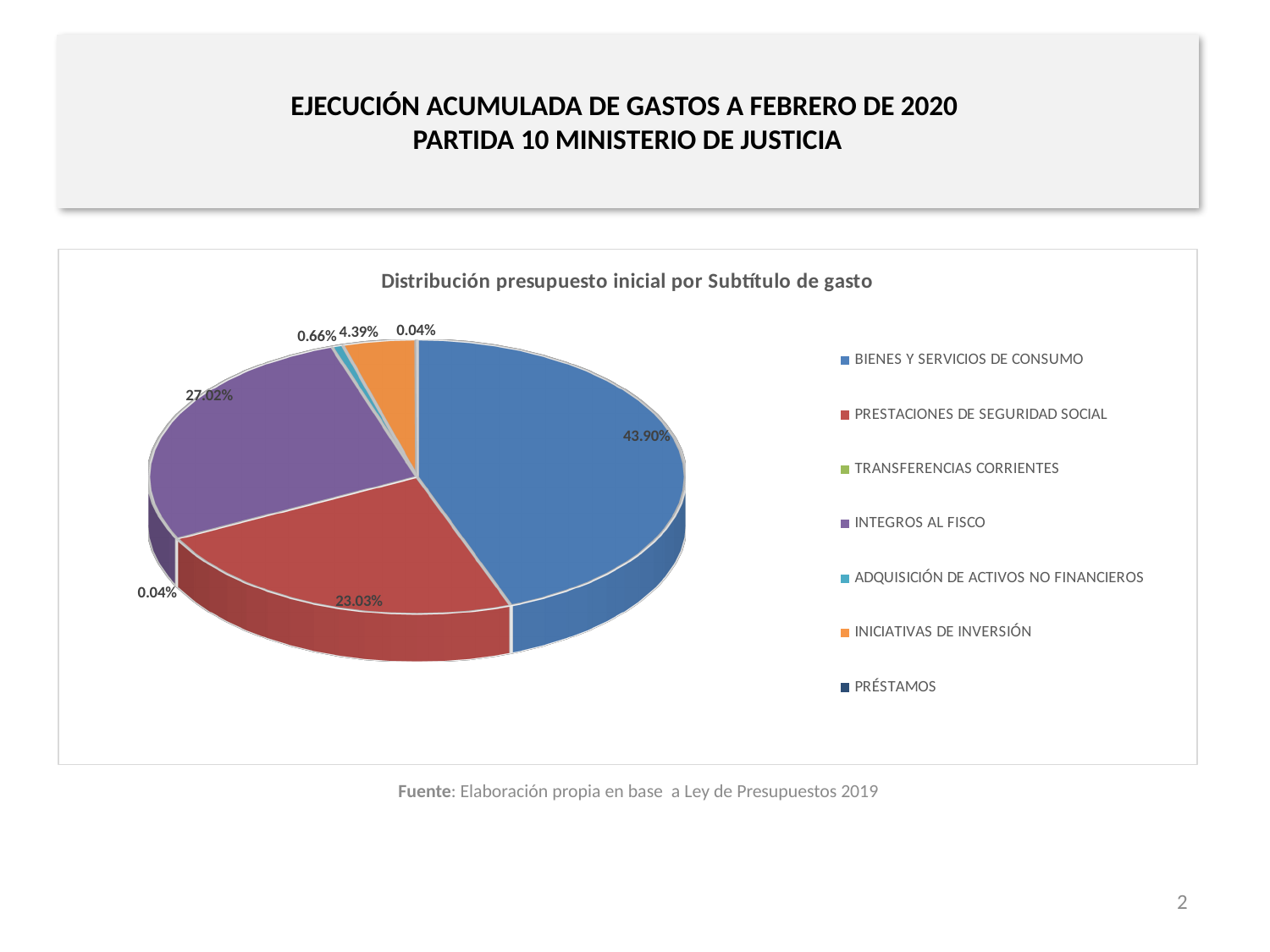
What share of the pie does INICIATIVAS DE INVERSIÓN represent? 4.39% What is the title of the chart? Distribución presupuesto inicial por Subtítulo de gasto What share of the pie does PRÉSTAMOS represent? 0.04% What is the difference in percentage points between the share for BIENES Y SERVICIOS DE CONSUMO and the share for INTEGROS AL FISCO? 16.88 What share of the pie does INTEGROS AL FISCO represent? 27.02% What share of the pie does BIENES Y SERVICIOS DE CONSUMO represent? 43.90% What share of the pie does ADQUISICIÓN DE ACTIVOS NO FINANCIEROS represent? 0.66% What kind of chart is shown on the slide? pie chart What share of the pie does PRESTACIONES DE SEGURIDAD SOCIAL represent? 23.03% Which category has the largest share of the pie? BIENES Y SERVICIOS DE CONSUMO How many categories does the legend of the pie chart list? 7 Which is larger, the share for INTEGROS AL FISCO or the share for PRESTACIONES DE SEGURIDAD SOCIAL? INTEGROS AL FISCO